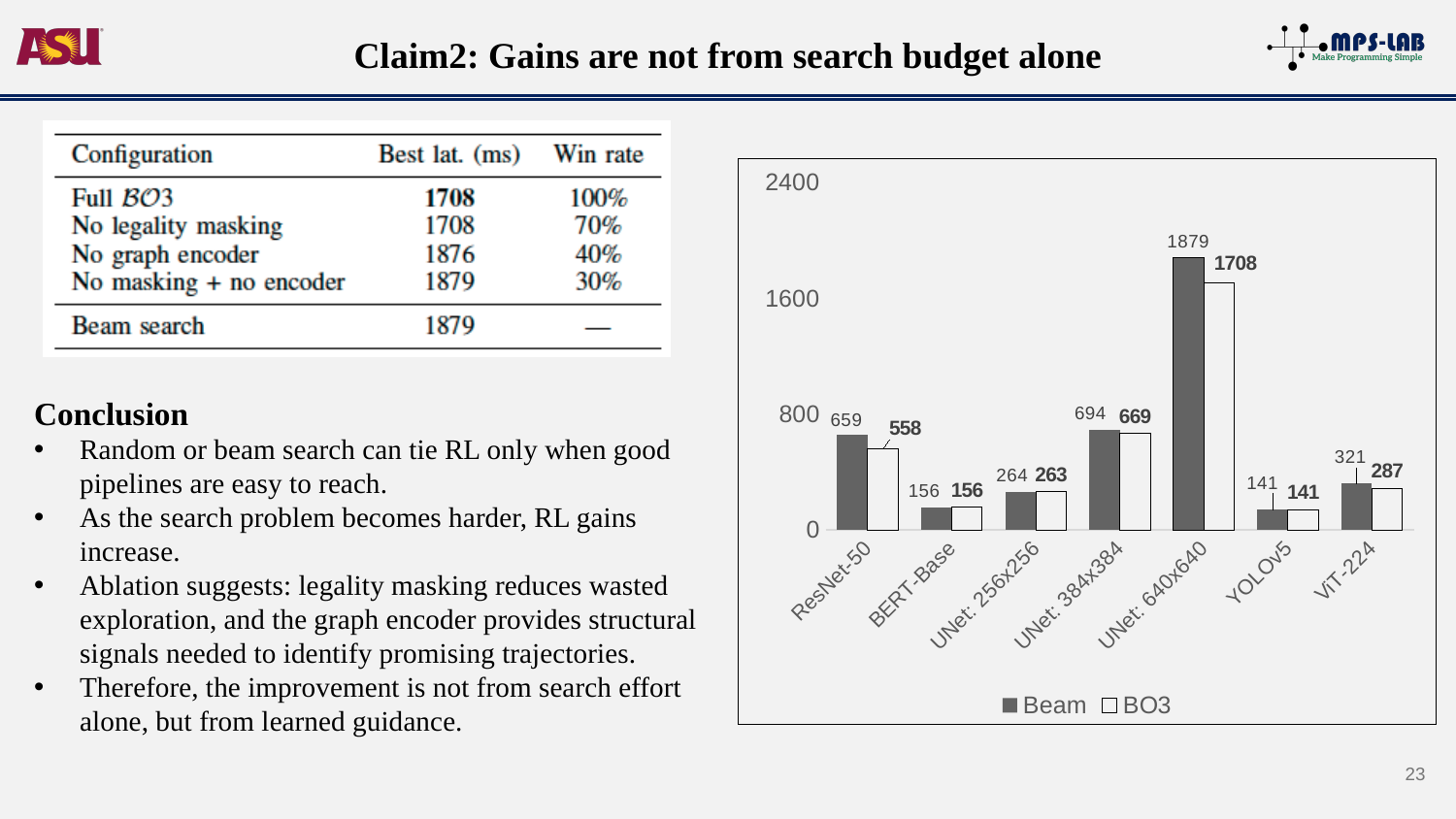
What is the difference between the Beam and BO3 values for UNet: 640x640? 171 What is the BO3 value for ViT-224? 287 What kind of chart is shown on the slide? bar chart Which category has the highest Beam value? UNet: 640x640 How many series does the legend list? 2 Which is larger for UNet: 384x384, the Beam value or the BO3 value? Beam How many categories are shown on the x axis? 7 Which category has the lowest BO3 value? YOLOv5 What are the two series named in the legend? Beam and BO3 What is the Beam value for ResNet-50? 659 What is the BO3 value for UNet: 640x640? 1708 What is the difference between the Beam and BO3 values for ResNet-50? 101